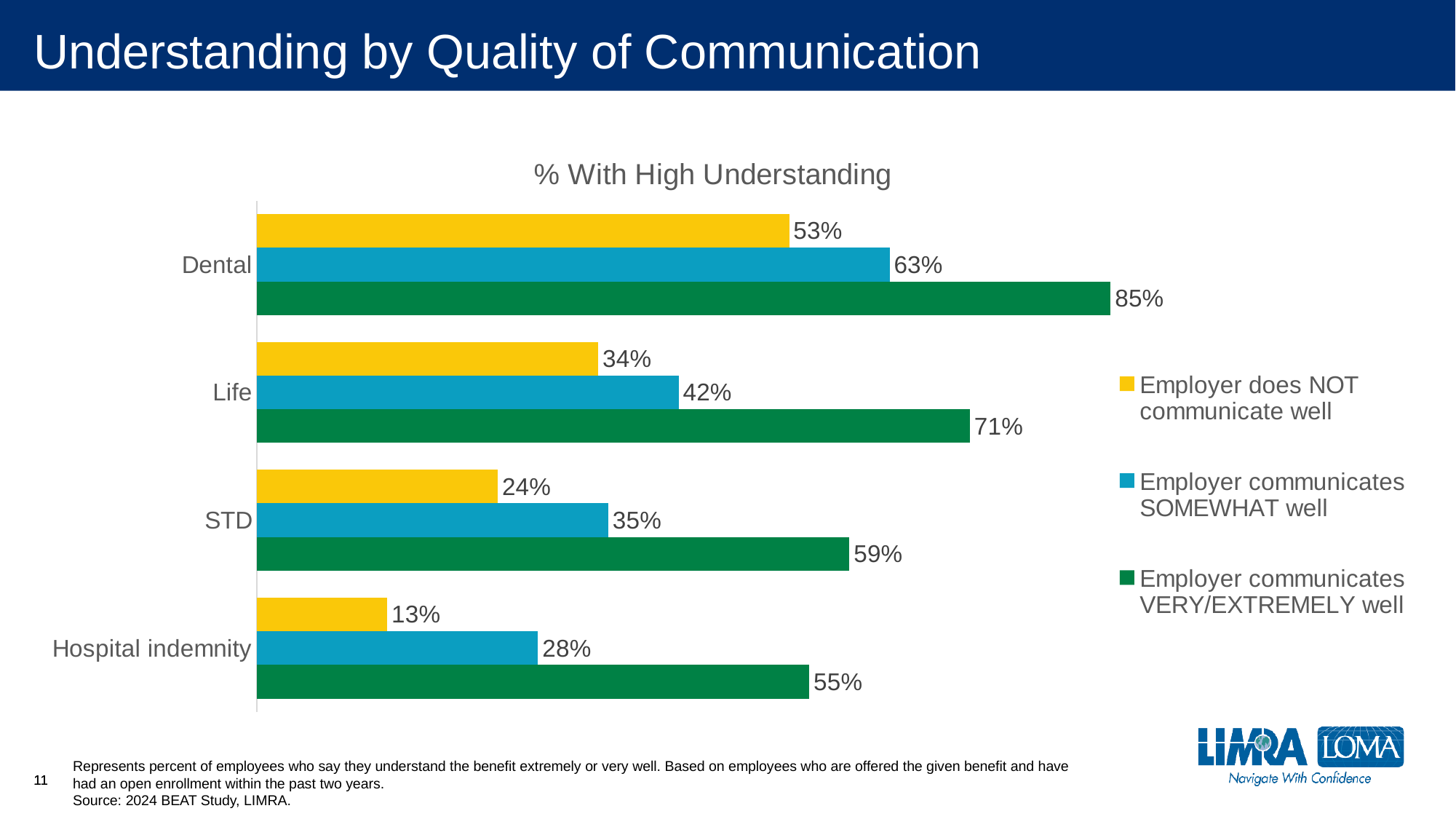
What is the difference between the Dental and Life values for the 'Employer communicates SOMEWHAT well' series? 21% What percentage of employees have high understanding of Dental benefits when the employer communicates VERY/EXTREMELY well? 85% What is the title of the chart? % With High Understanding Which benefit has the lowest value for the 'Employer does NOT communicate well' series? Hospital indemnity What is the value for Life when the employer communicates SOMEWHAT well? 42% Which benefit has the highest value for the 'Employer communicates VERY/EXTREMELY well' series? Dental Which is larger: the SOMEWHAT well value for STD or the NOT well value for Life? STD SOMEWHAT well (35%) What is the difference between the VERY/EXTREMELY well and NOT well values for STD? 35% How many benefit categories are shown on the chart? 4 What is the value for Hospital indemnity when the employer does NOT communicate well? 13% How many series does the legend list? 3 What type of chart is shown on the slide? Bar chart